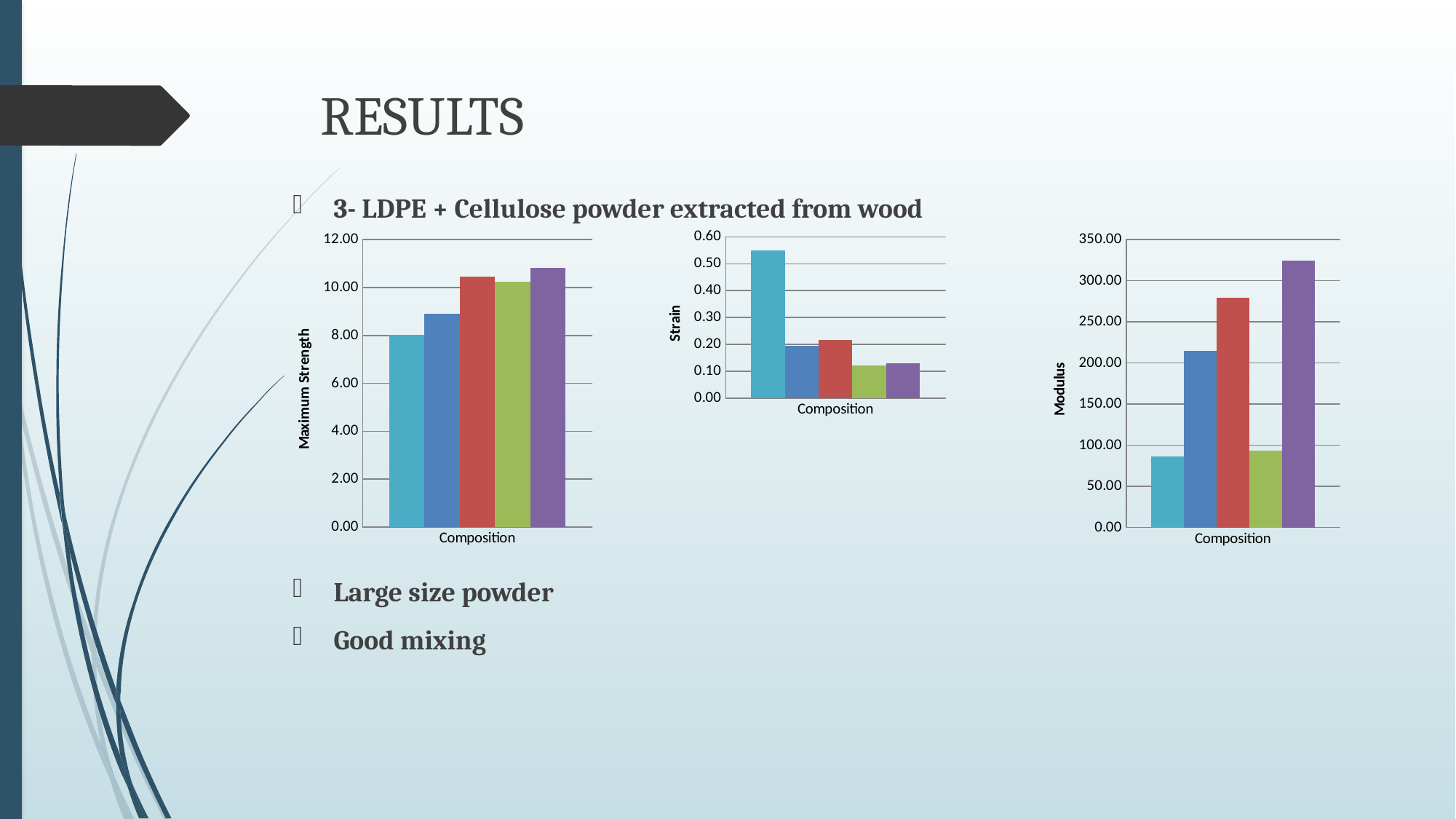
In the middle chart (Strain), which coloured bar is the tallest? teal In the left chart (Maximum Strength), which coloured bar is the shortest? teal In the right chart (Modulus), is the value of the purple bar greater or less than 300.00? greater In the left chart (Maximum Strength), is the value of the blue bar greater or less than 10.00? less In the right chart (Modulus), which is larger, the red bar or the blue bar? red In the right chart (Modulus), which coloured bar is the tallest? purple What is the y-axis title of the right chart? Modulus In the middle chart (Strain), is the value of the green bar greater or less than 0.20? less In the left chart (Maximum Strength), which coloured bar is the tallest? purple What kind of chart is the left chart with the y-axis labelled Maximum Strength? bar chart In the left chart (Maximum Strength), how many bars are plotted? 5